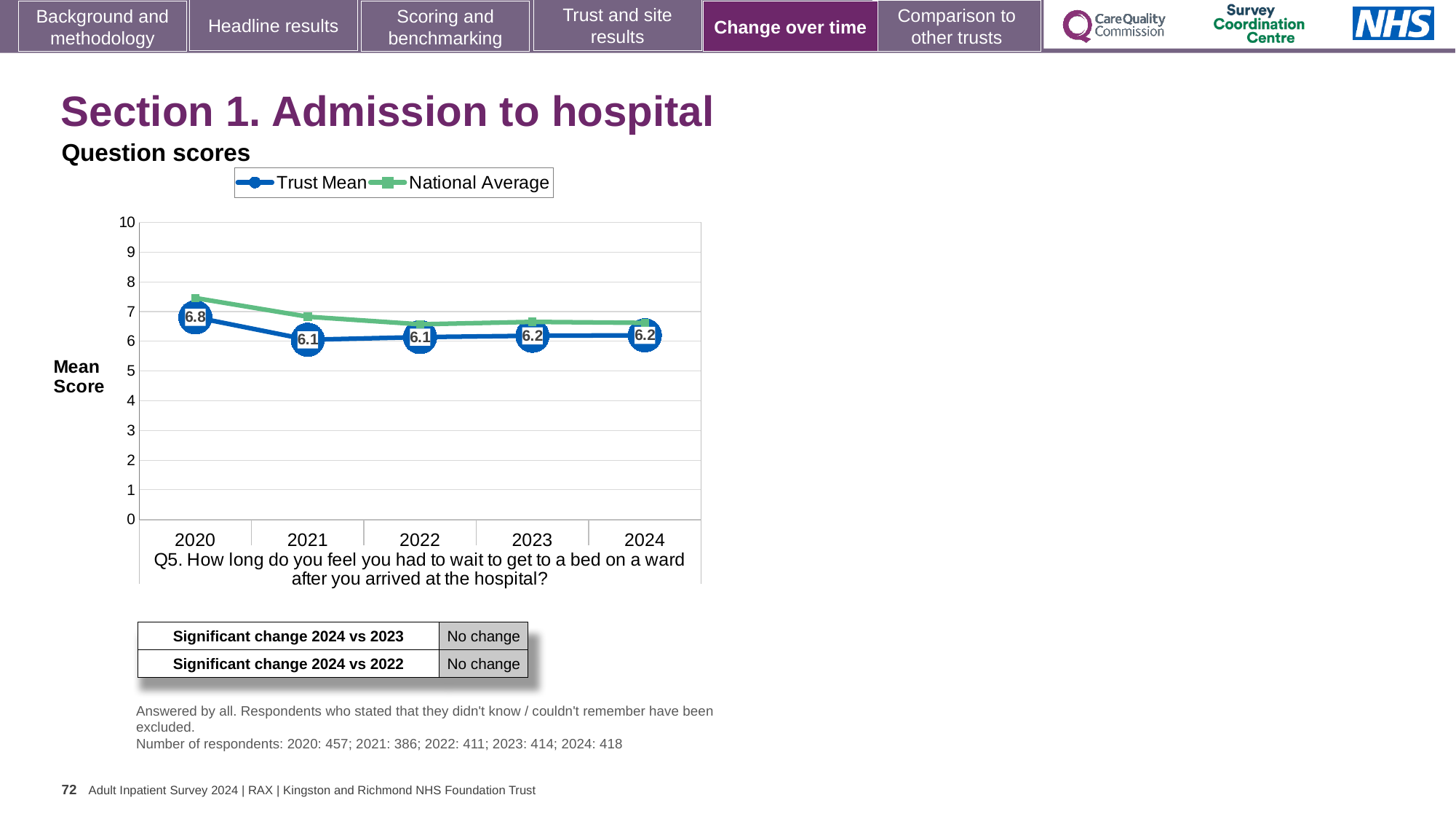
Is the National Average value for 2020 greater or less than 7? greater In which year is the Trust Mean score highest? 2020 What is the difference between the Trust Mean score in 2020 and in 2021? 0.7 What is the Trust Mean score for 2024? 6.2 How many years are shown on the x axis of the chart? 5 Which year has the larger Trust Mean score, 2020 or 2023? 2020 What is the Trust Mean score for 2021? 6.1 What is the Trust Mean score for 2020? 6.8 How many series does the chart legend list? 2 What is the lowest Trust Mean score shown on the chart? 6.1 Is the National Average value for 2022 greater or less than 7? less In 2020, which series has the higher value, Trust Mean or National Average? National Average